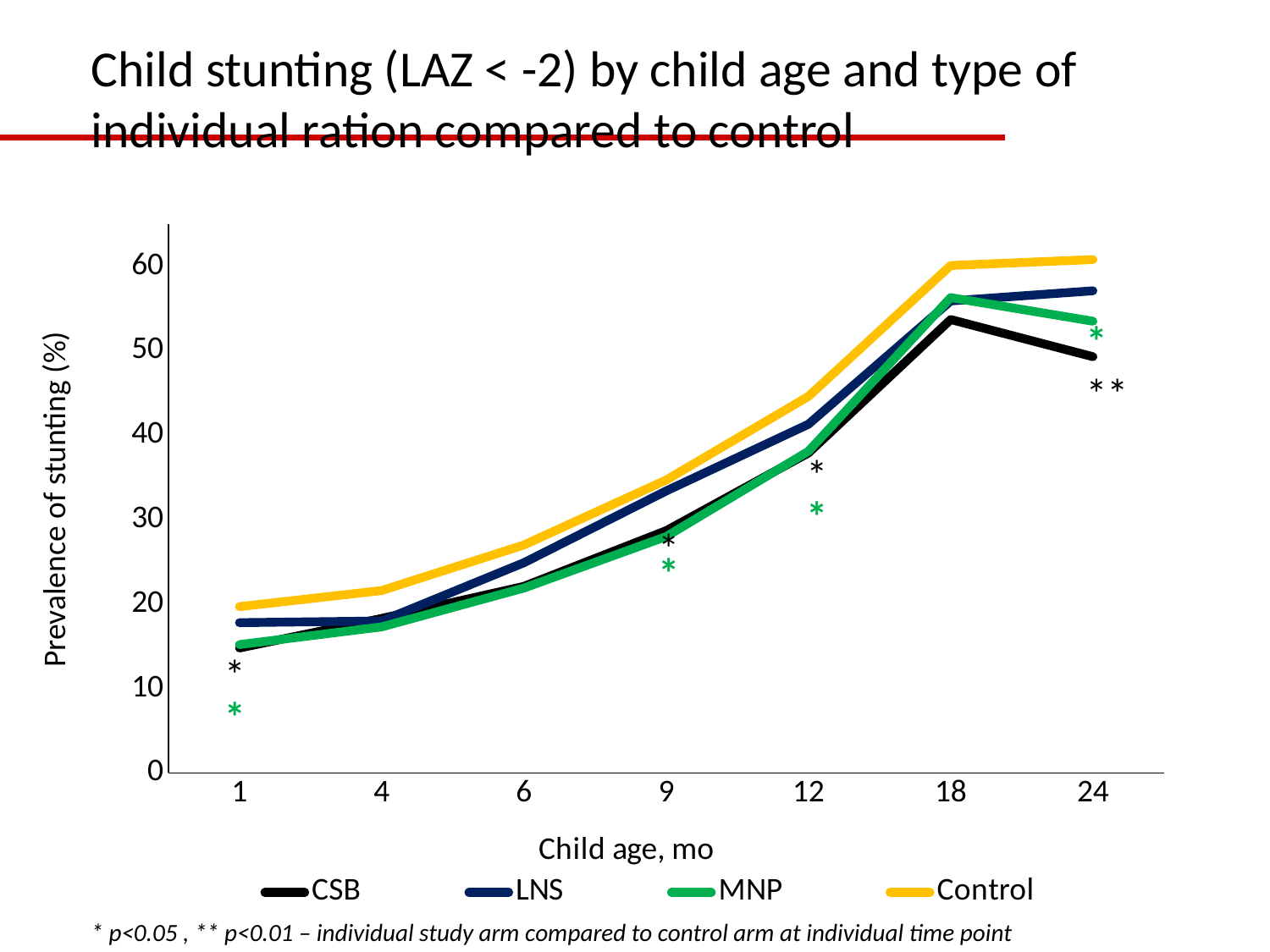
Is the value for Control at 24 months greater or less than 50? greater At 12 months, which is larger: the value for Control or the value for CSB? Control Is the value for LNS at 12 months greater or less than 30? greater What is the title of the x axis? Child age, mo Does the Control line rise or fall from 1 month to 18 months? rises Which series has the highest prevalence of stunting at 24 months? Control Which series has the lowest prevalence of stunting at 24 months? CSB Is the value for CSB at 1 month greater or less than 20? less How many child age points are shown on the x axis? 7 How many series does the legend list? 4 What is the title of the y axis? Prevalence of stunting (%) What kind of chart is shown on the slide? line chart